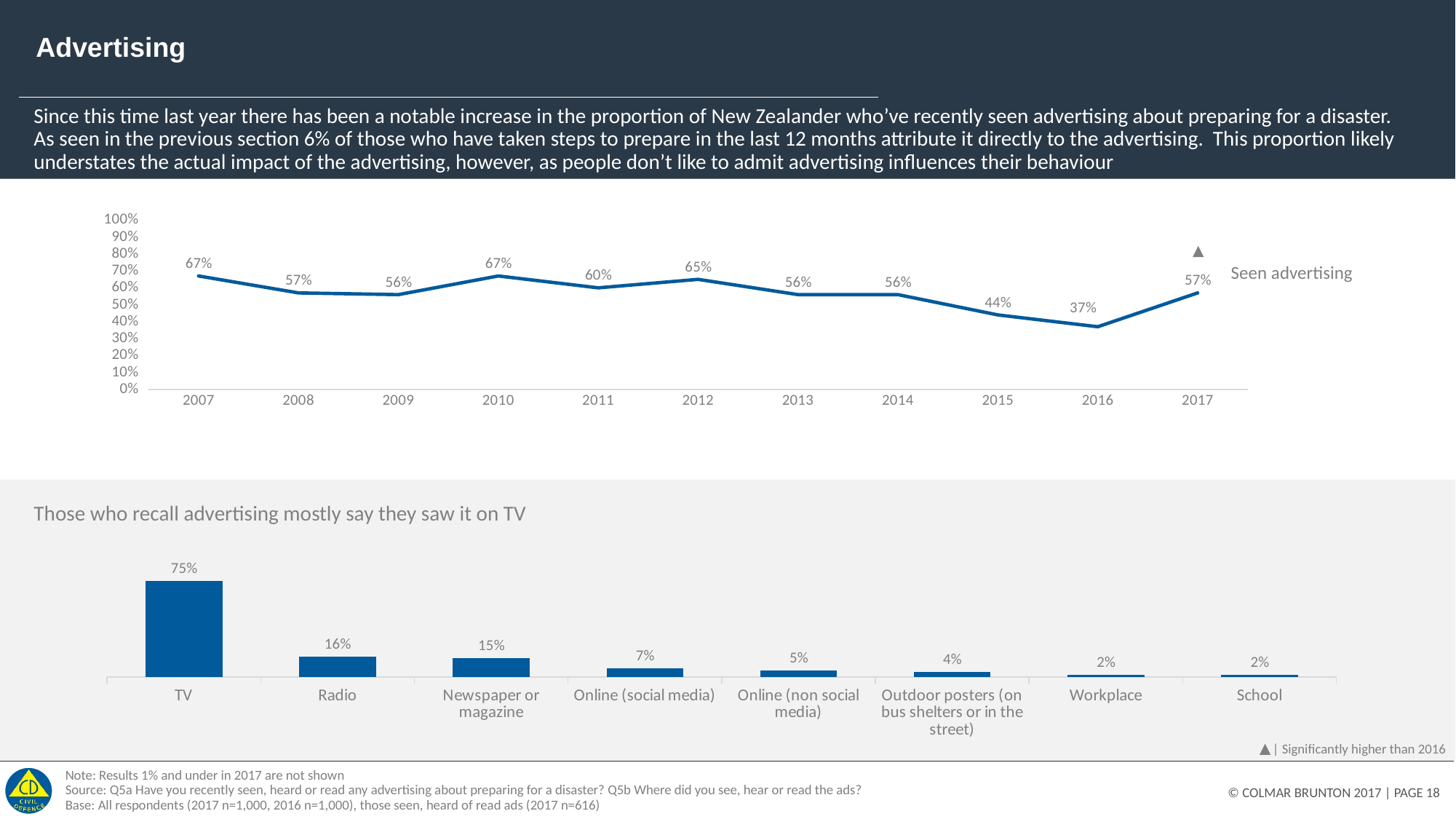
In the bottom bar chart, what is the value for Radio? 16% In the top line chart, is the value for 2015 greater or less than 50%? less In the bottom bar chart, what is the difference between the TV and Radio values? 59 percentage points In the top line chart, what percentage had seen advertising in 2016? 37% In the bottom bar chart, what percentage of those who recall advertising saw it on TV? 75% In the bottom bar chart, how many categories are shown? 8 In the top line chart, by how many percentage points did the seen advertising value change from 2016 to 2017? 20 percentage points In the top line chart, how many years are plotted on the x axis? 11 In the top line chart, what percentage had seen advertising in 2017? 57% In the top line chart, which is larger: the value for 2012 or the value for 2013? 2012 In the top line chart, which year has the lowest value for seen advertising? 2016 What type of chart is the bottom chart on the slide? Bar chart